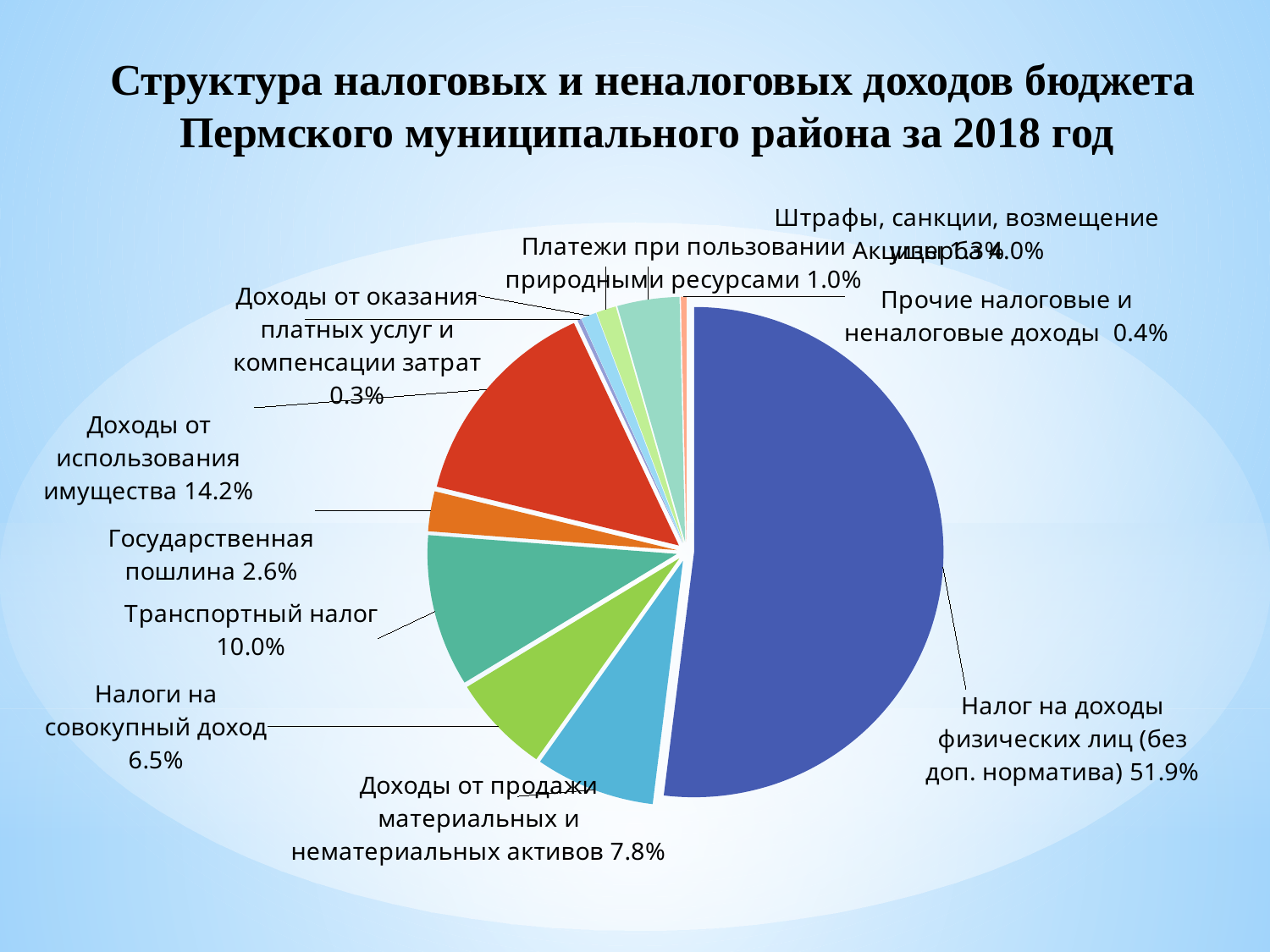
For which year does the chart show the budget revenue structure? 2018 Which is larger: Налоги на совокупный доход or Доходы от продажи материальных и нематериальных активов? Доходы от продажи материальных и нематериальных активов What share of the budget revenue is Налог на доходы физических лиц (без доп. норматива)? 51.9% What is the value for Доходы от продажи материальных и нематериальных активов? 7.8% What is the value for Платежи при пользовании природными ресурсами? 1.0% Which category has the largest share of the pie? Налог на доходы физических лиц (без доп. норматива) Which category has the smallest share of the pie? Доходы от оказания платных услуг и компенсации затрат What is the value for Доходы от использования имущества? 14.2% What is the value for Транспортный налог? 10.0% What is the difference between Доходы от использования имущества and Транспортный налог? 4.2% What kind of chart is shown on the slide? pie chart What is the value for Государственная пошлина? 2.6%